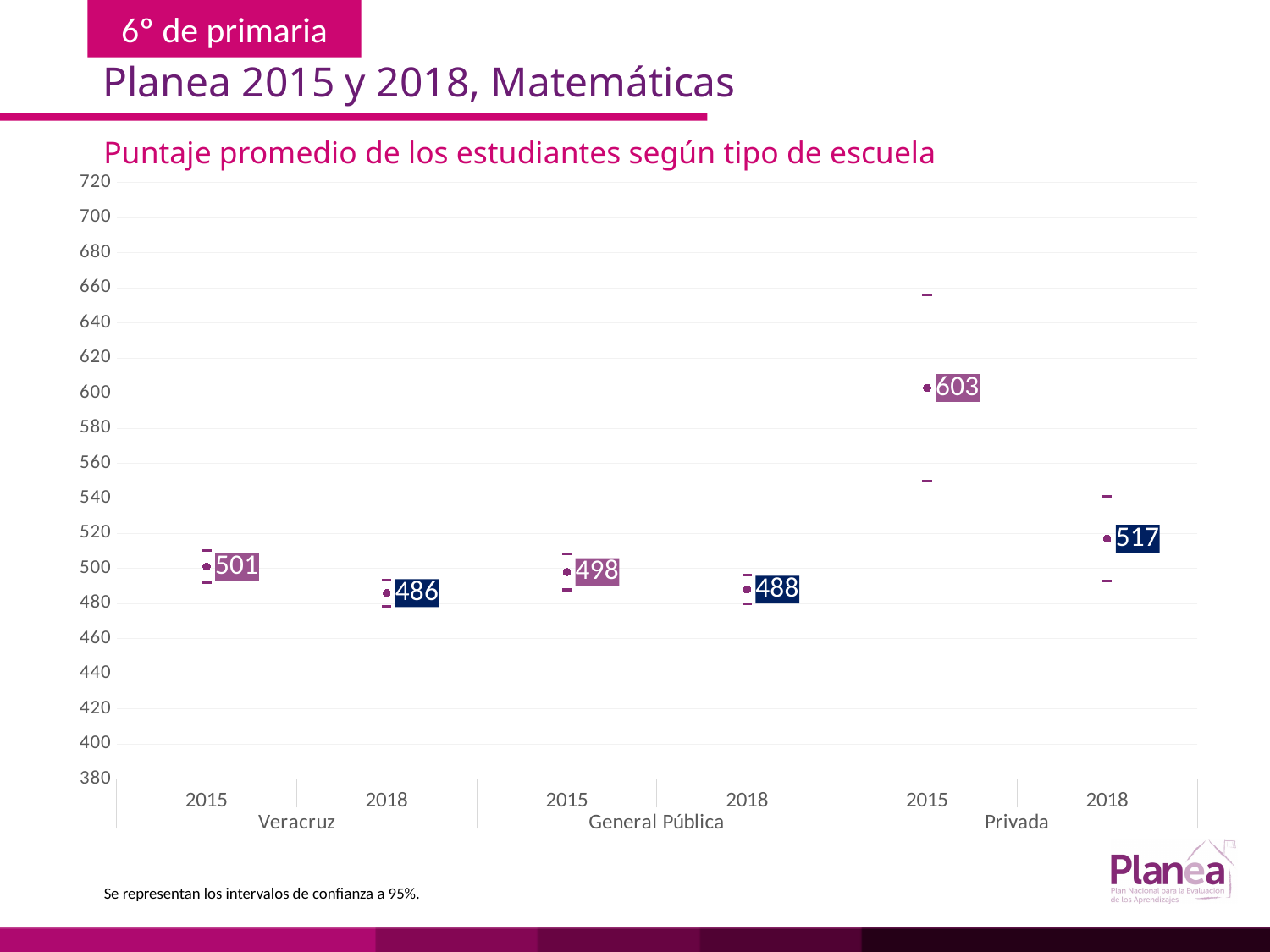
Which school type and year has the highest average score? Privada 2015 How many data points are plotted in the chart? 6 What is the difference between the Veracruz scores in 2015 and 2018? 15 Which school type and year has the lowest average score? Veracruz 2018 Did the Veracruz average score rise or fall from 2015 to 2018? fall What is the difference between the Privada scores in 2015 and 2018? 86 What is the average score for Veracruz in 2018? 486 What is the average score for Veracruz in 2015? 501 What is the average score for Privada in 2018? 517 What is the average score for Privada in 2015? 603 Which is larger, the General Pública score in 2018 or the Veracruz score in 2018? General Pública 2018 What is the average score for General Pública in 2015? 498